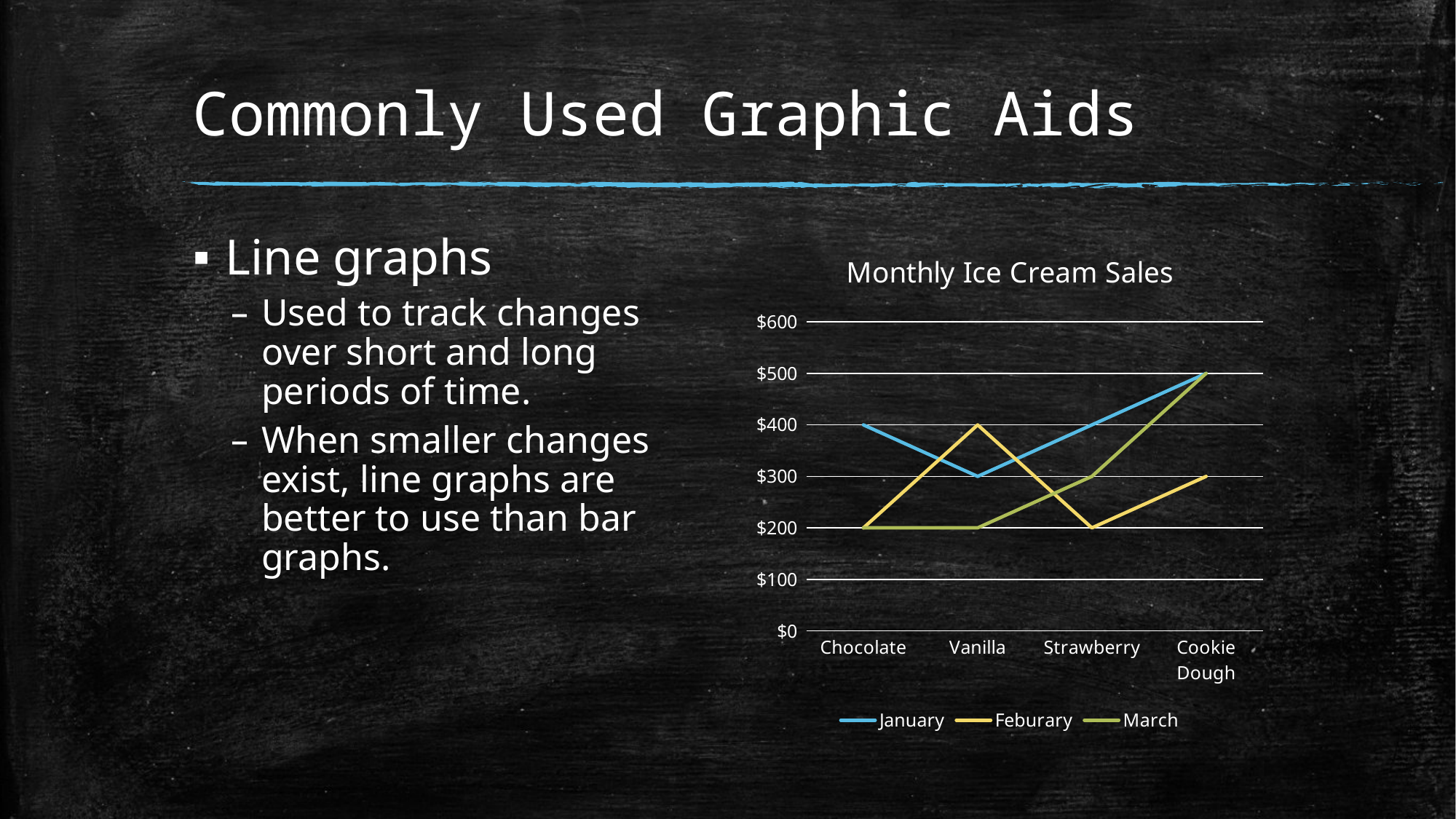
What is the January value for Chocolate? $400 Which is larger for Vanilla, the January value or the Feburary value? Feburary What is the March value for Strawberry? $300 What kind of chart is shown on the slide? line chart What is the difference between the January and Feburary values for Strawberry? $200 How many categories are shown on the x axis of the chart? 4 Do the March values rise or fall from Vanilla to Cookie Dough? rise Which category has the lowest January value? Vanilla Which category has the highest January value? Cookie Dough How many series does the chart legend list? 3 What is the Feburary value for Vanilla? $400 What is the title of the chart? Monthly Ice Cream Sales